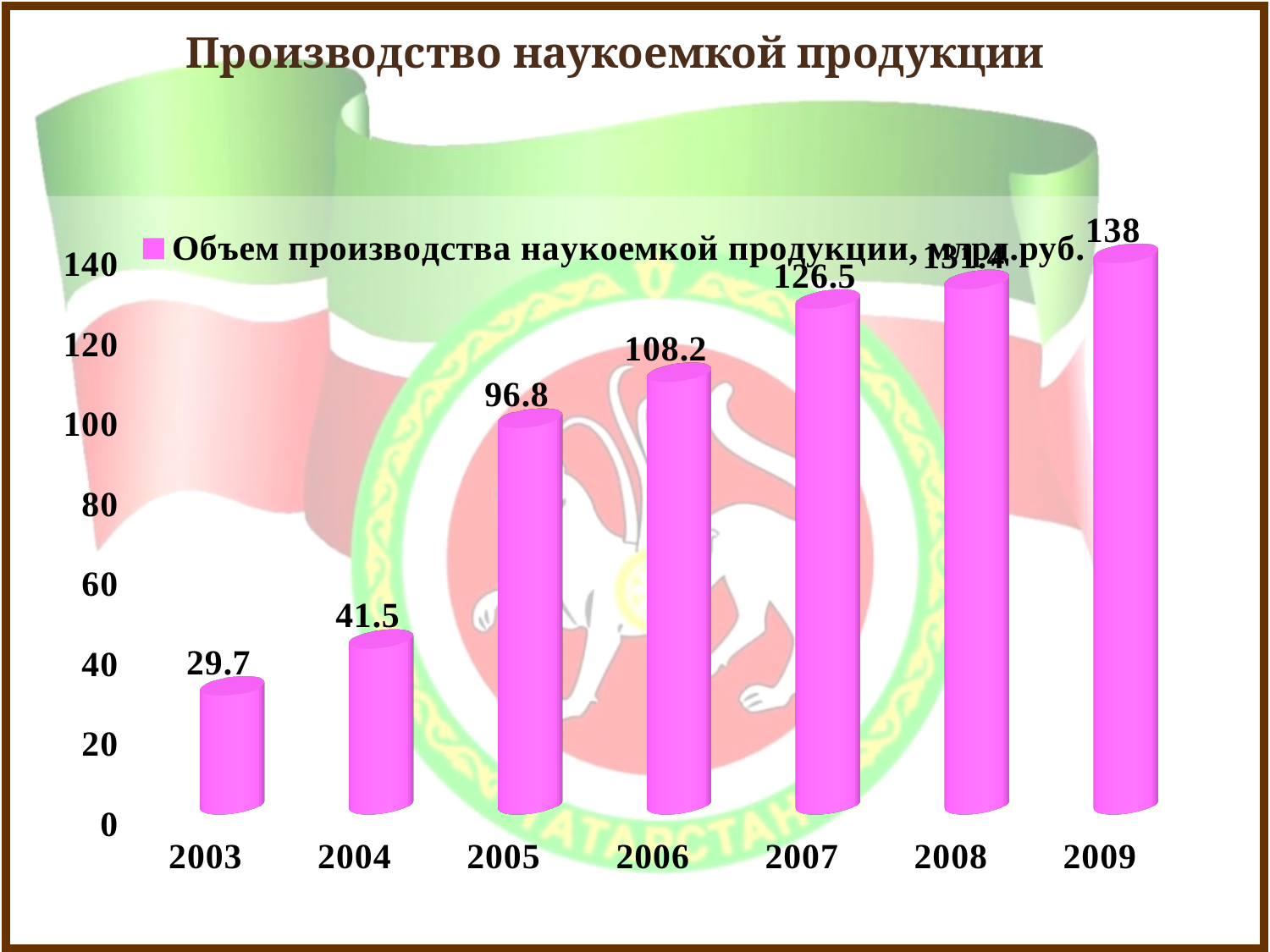
What is the value for 2007? 126.5 What is the difference between the values for 2004 and 2003? 11.8 What kind of chart is shown on the slide? bar chart What is the value for 2009? 138 Which year has the lowest value? 2003 How many years are shown on the x axis? 7 Which is larger, the value for 2006 or the value for 2005? 2006 Is the value for 2008 greater or less than 120? greater Do the values rise or fall from 2003 to 2009? rise What is the value for 2003? 29.7 What is the value for 2005? 96.8 Which year has the highest value? 2009